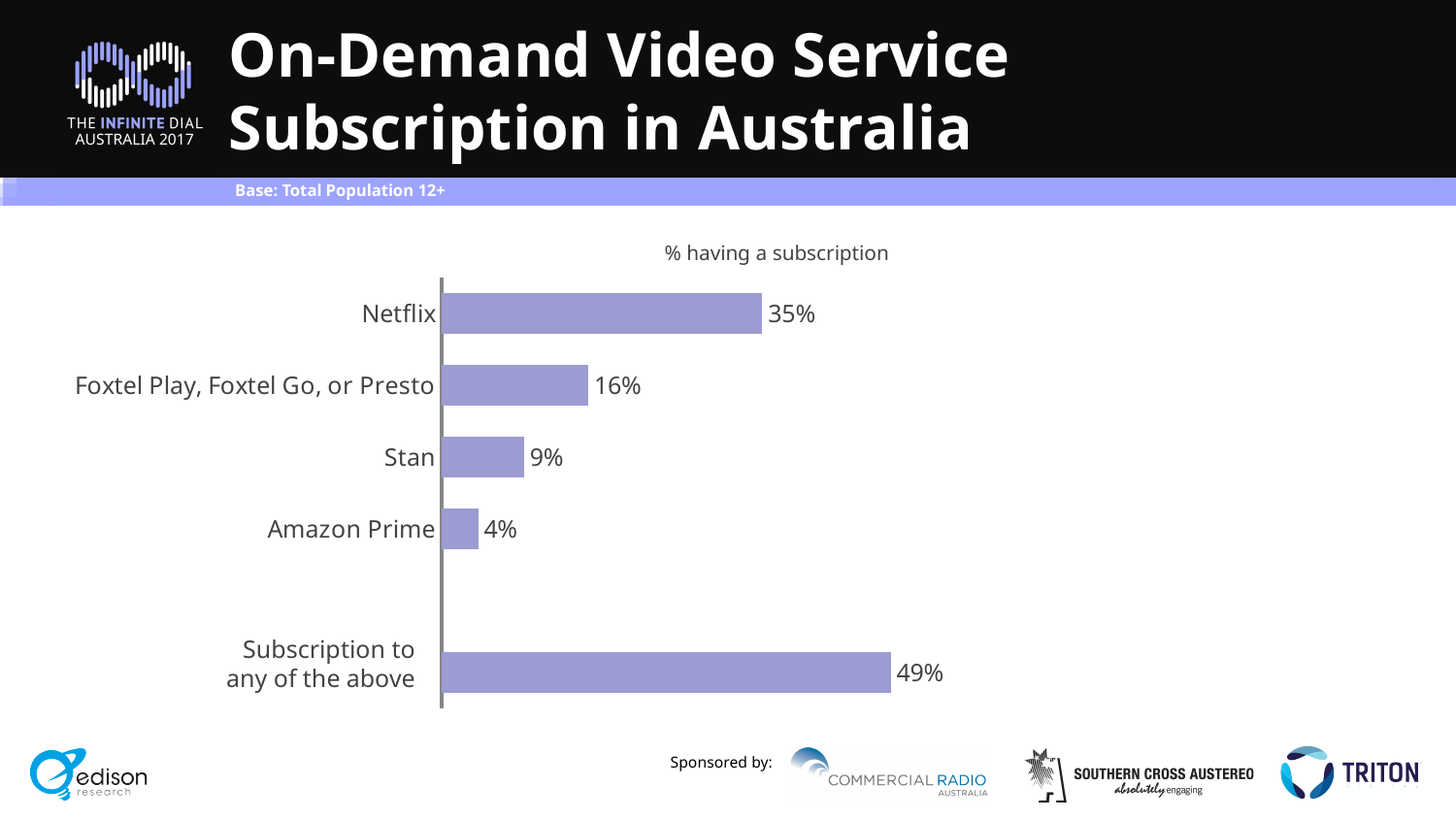
What kind of chart is shown on the slide? Bar chart Which category has the lowest value on the chart? Amazon Prime What percentage has a subscription to any of the above services? 49% Which is larger, the value for Foxtel Play, Foxtel Go, or Presto or the value for Stan? Foxtel Play, Foxtel Go, or Presto What is the value shown for Foxtel Play, Foxtel Go, or Presto? 16% Which individual service has the highest subscription percentage? Netflix What is the value for Amazon Prime? 4% What percentage has a Stan subscription? 9% What is the title shown above the chart? % having a subscription What percentage of the population has a Netflix subscription? 35% What is the difference between the Netflix value and the Stan value? 26% How many categories are shown on the chart? 5